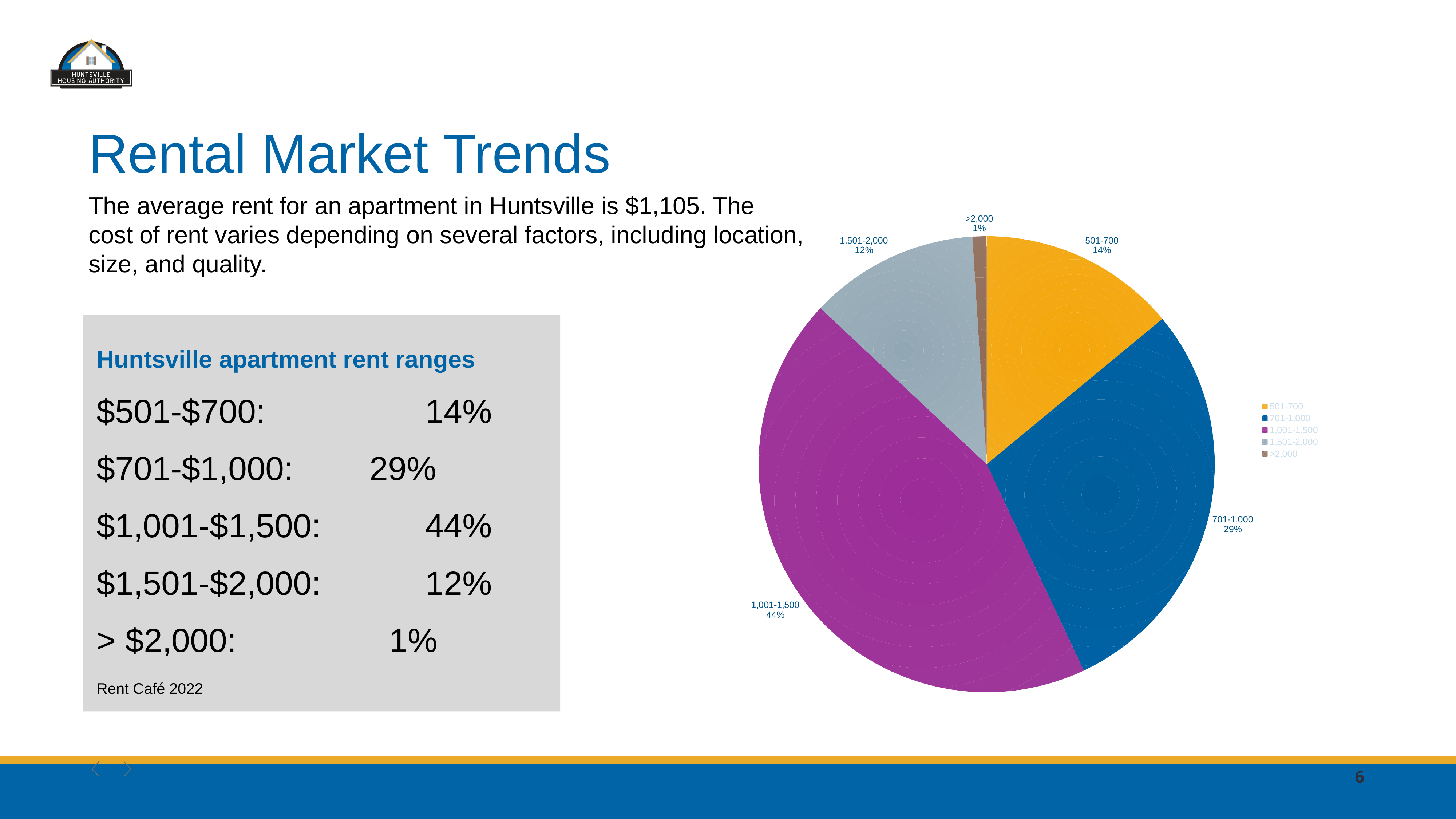
How many slices does the pie chart have? 5 What share of the pie does the 1,001-1,500 slice represent? 44% What share of the pie does the >2,000 slice represent? 1% What share of the pie does the 1,501-2,000 slice represent? 12% What is the difference in percentage points between the 1,001-1,500 slice and the 701-1,000 slice? 15% Which slice is larger, 501-700 or 1,501-2,000? 501-700 Which rent range has the largest slice of the pie? 1,001-1,500 What colour is the 1,001-1,500 slice in the pie chart? Purple What kind of chart is shown on the slide? Pie chart Which rent range has the smallest slice of the pie? >2,000